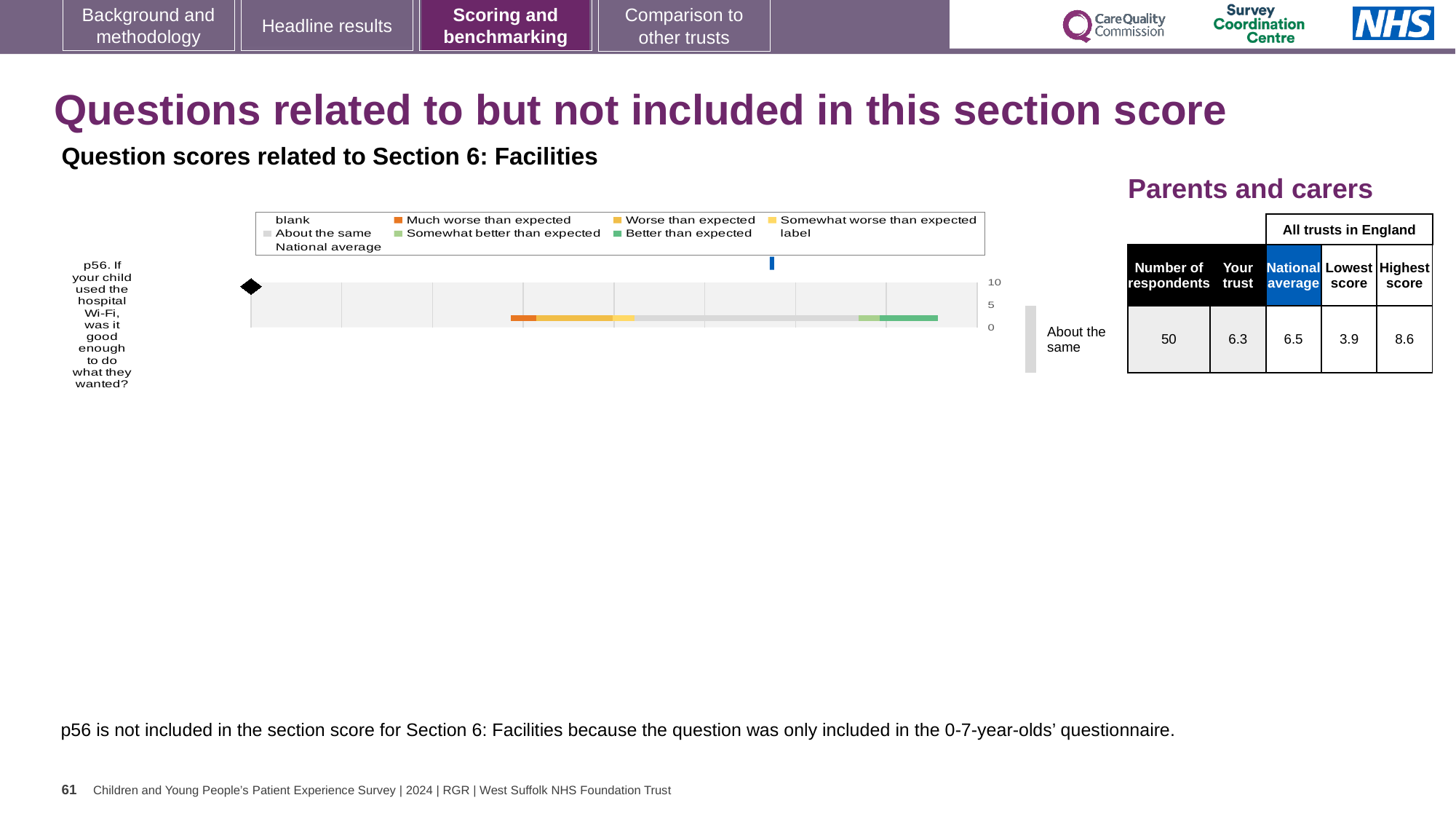
What is the lowest score among all trusts in England for p56? 3.9 What is the highest score among all trusts in England for p56? 8.6 How many survey questions are plotted in the chart? 1 Is the 'Your trust' score for p56 greater or less than 5? greater By how much does the national average exceed the 'Your trust' score for p56? 0.2 What is the national average score for p56? 6.5 What kind of chart is shown on the slide for question p56? bar chart Which is larger for p56, the 'Your trust' score or the national average? National average How many respondents answered p56? 50 What is the difference between the highest and lowest scores for p56? 4.7 What is the 'Your trust' score for p56 (hospital Wi-Fi)? 6.3 Which benchmarking category is the trust's p56 score placed in? About the same